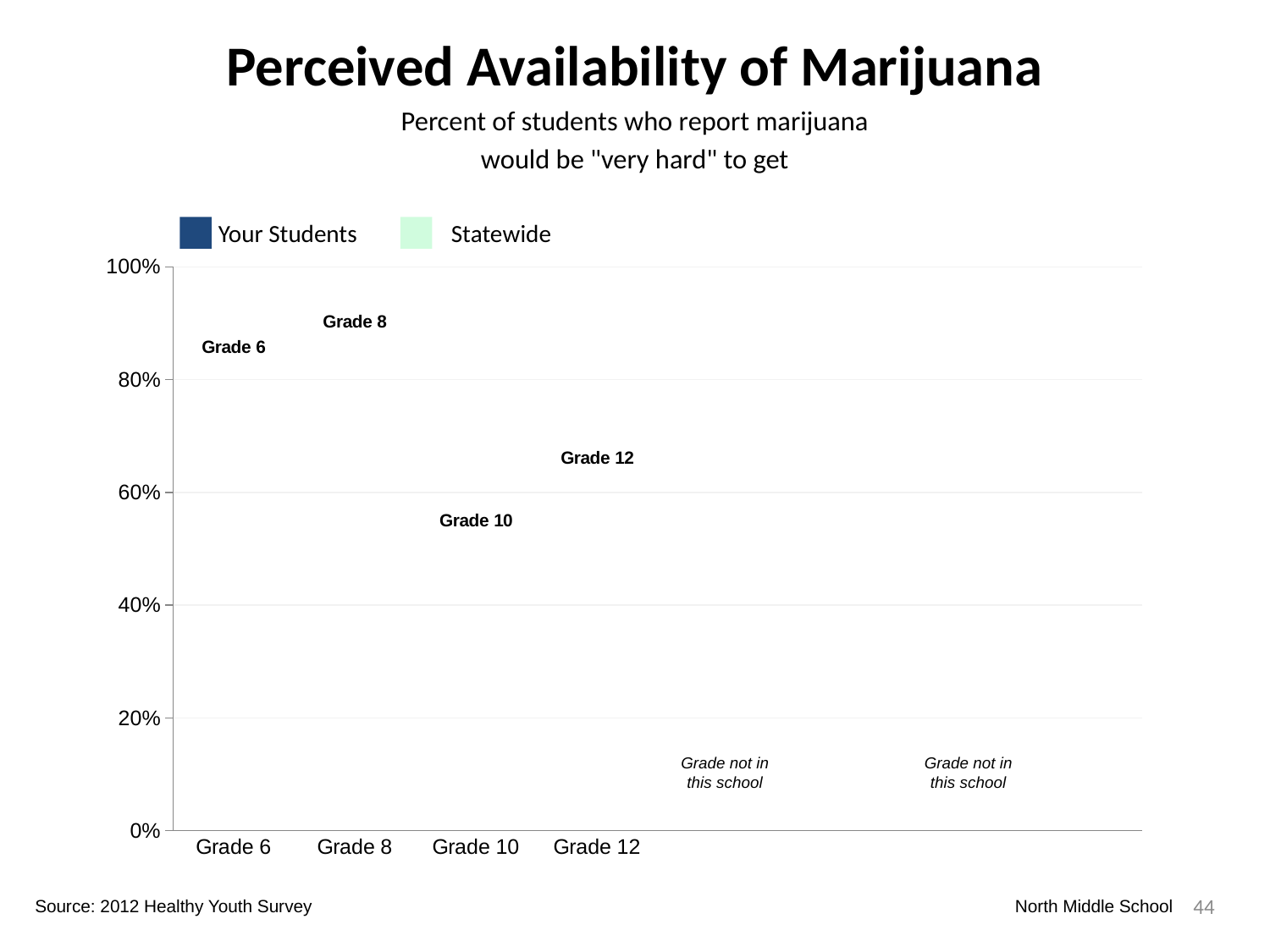
What is the title of the chart? Perceived Availability of Marijuana What is the highest value shown on the y axis? 100% How many series does the legend list? 2 How many grade categories are labelled on the x axis? 4 What are the two series named in the legend? Your Students and Statewide How many positions on the chart are marked "Grade not in this school"? 2